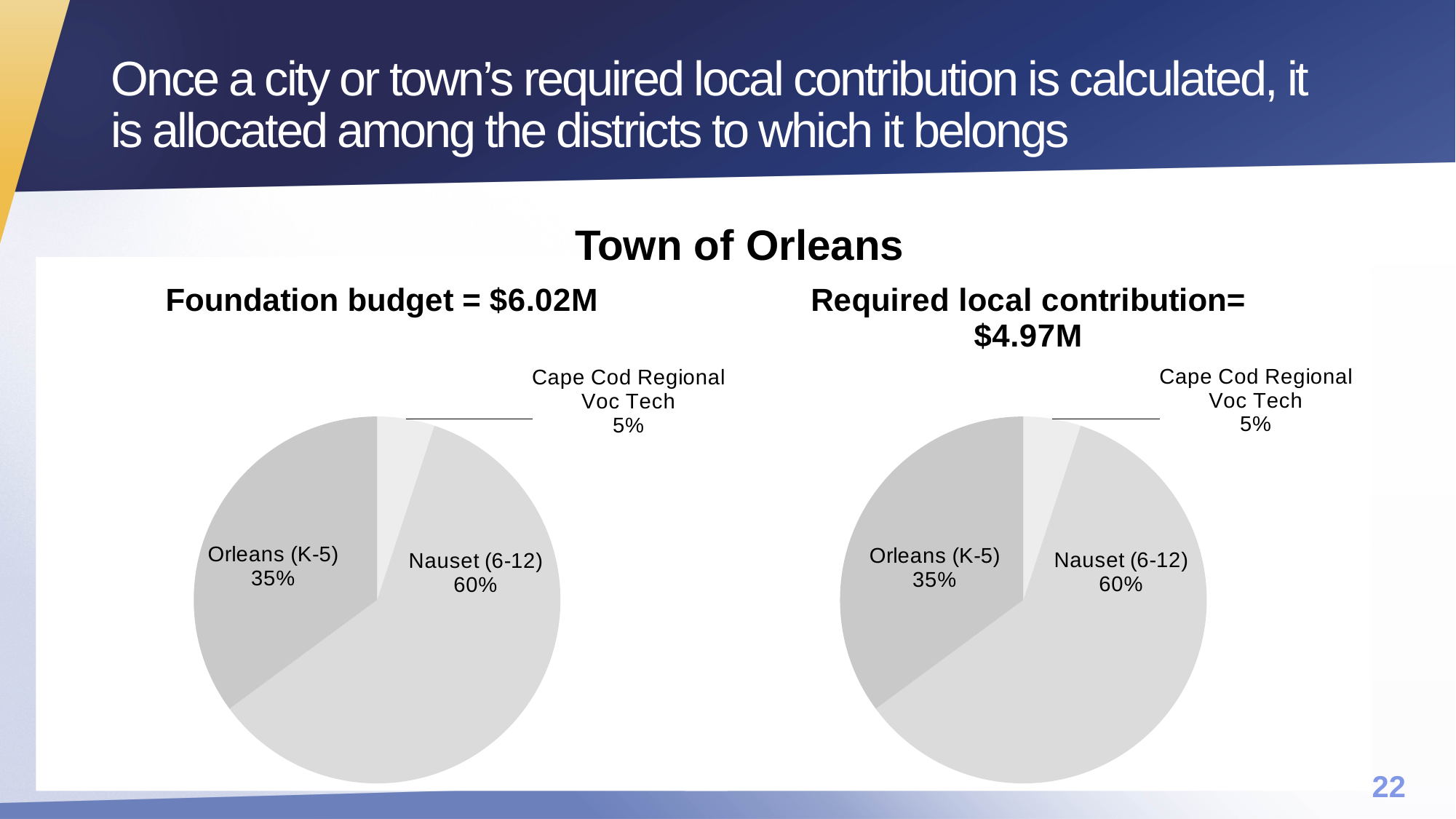
What is the title of the left chart? Foundation budget = $6.02M In the 'Foundation budget = $6.02M' chart, what share does Orleans (K-5) have? 35% In the 'Required local contribution= $4.97M' chart, what share does Nauset (6-12) have? 60% What type of chart is the 'Required local contribution= $4.97M' chart? Pie chart In the 'Foundation budget = $6.02M' chart, which district has the largest slice? Nauset (6-12) Which town do the two charts on the slide describe? Town of Orleans In the 'Foundation budget = $6.02M' chart, what is the difference in percentage points between Nauset (6-12) and Orleans (K-5)? 25 In the 'Required local contribution= $4.97M' chart, which is larger, Orleans (K-5) or Cape Cod Regional Voc Tech? Orleans (K-5) In the 'Foundation budget = $6.02M' chart, what share does Nauset (6-12) have? 60% How many slices does the 'Foundation budget = $6.02M' chart have? 3 In the 'Required local contribution= $4.97M' chart, which district has the smallest slice? Cape Cod Regional Voc Tech